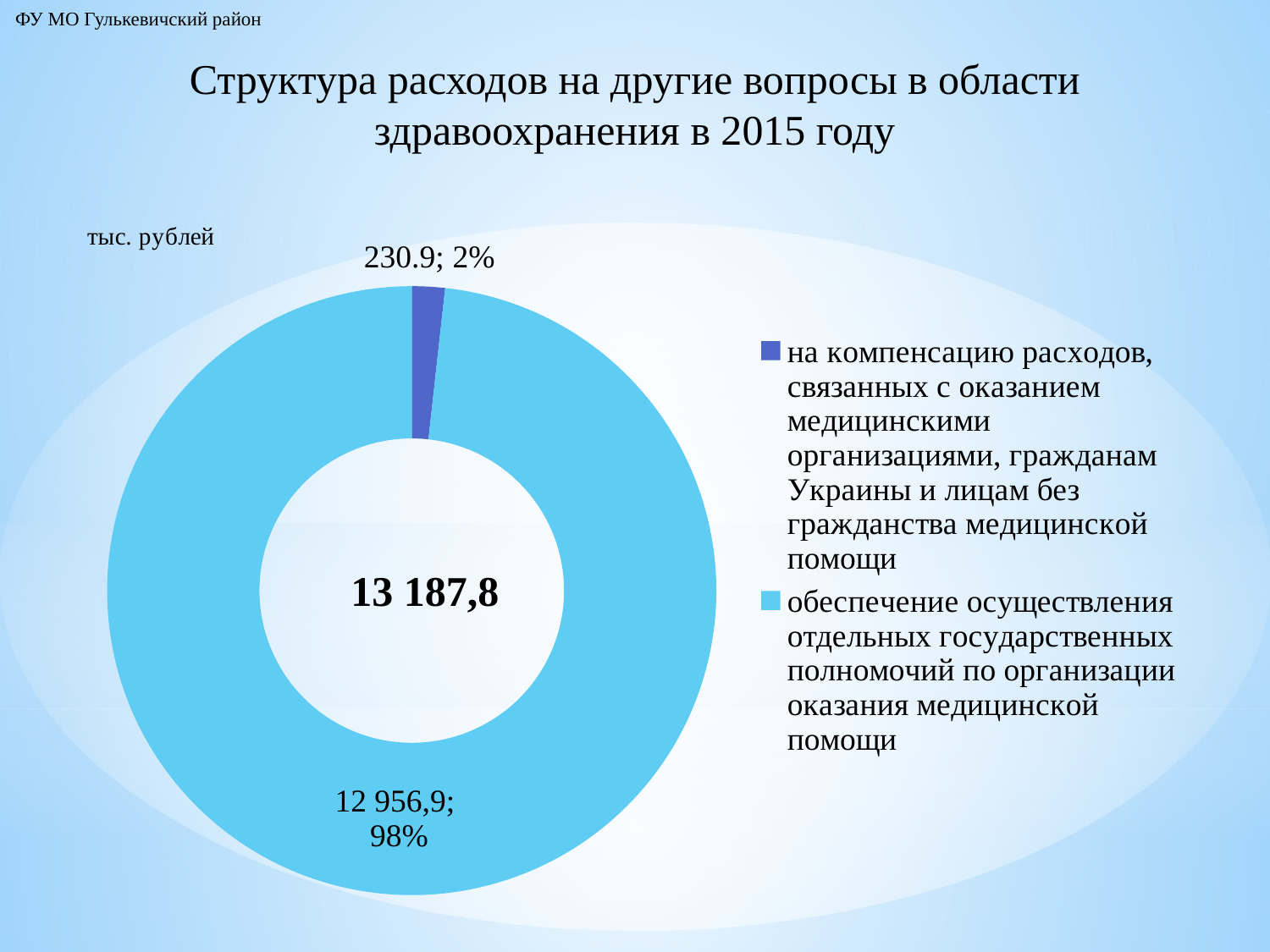
What share of the chart does the slice for 'на компенсацию расходов, связанных с оказанием медицинскими организациями, гражданам Украины и лицам без гражданства медицинской помощи' represent? 2% What is the value for 'на компенсацию расходов, связанных с оказанием медицинскими организациями, гражданам Украины и лицам без гражданства медицинской помощи'? 230.9 What kind of chart is shown on the slide? Doughnut (pie) chart Which category has the smallest slice? на компенсацию расходов, связанных с оказанием медицинскими организациями, гражданам Украины и лицам без гражданства медицинской помощи What is the title of the chart? Структура расходов на другие вопросы в области здравоохранения в 2015 году Which is larger: the slice for 'обеспечение осуществления отдельных государственных полномочий...' or the slice for 'на компенсацию расходов...'? обеспечение осуществления отдельных государственных полномочий по организации оказания медицинской помощи Which category has the largest slice? обеспечение осуществления отдельных государственных полномочий по организации оказания медицинской помощи In what units are the values on the chart given? тыс. рублей How many categories does the legend list? 2 What share of the chart does the slice for 'обеспечение осуществления отдельных государственных полномочий по организации оказания медицинской помощи' represent? 98% What is the value for 'обеспечение осуществления отдельных государственных полномочий по организации оказания медицинской помощи'? 12 956,9 What total value is shown in the centre of the doughnut chart? 13 187,8